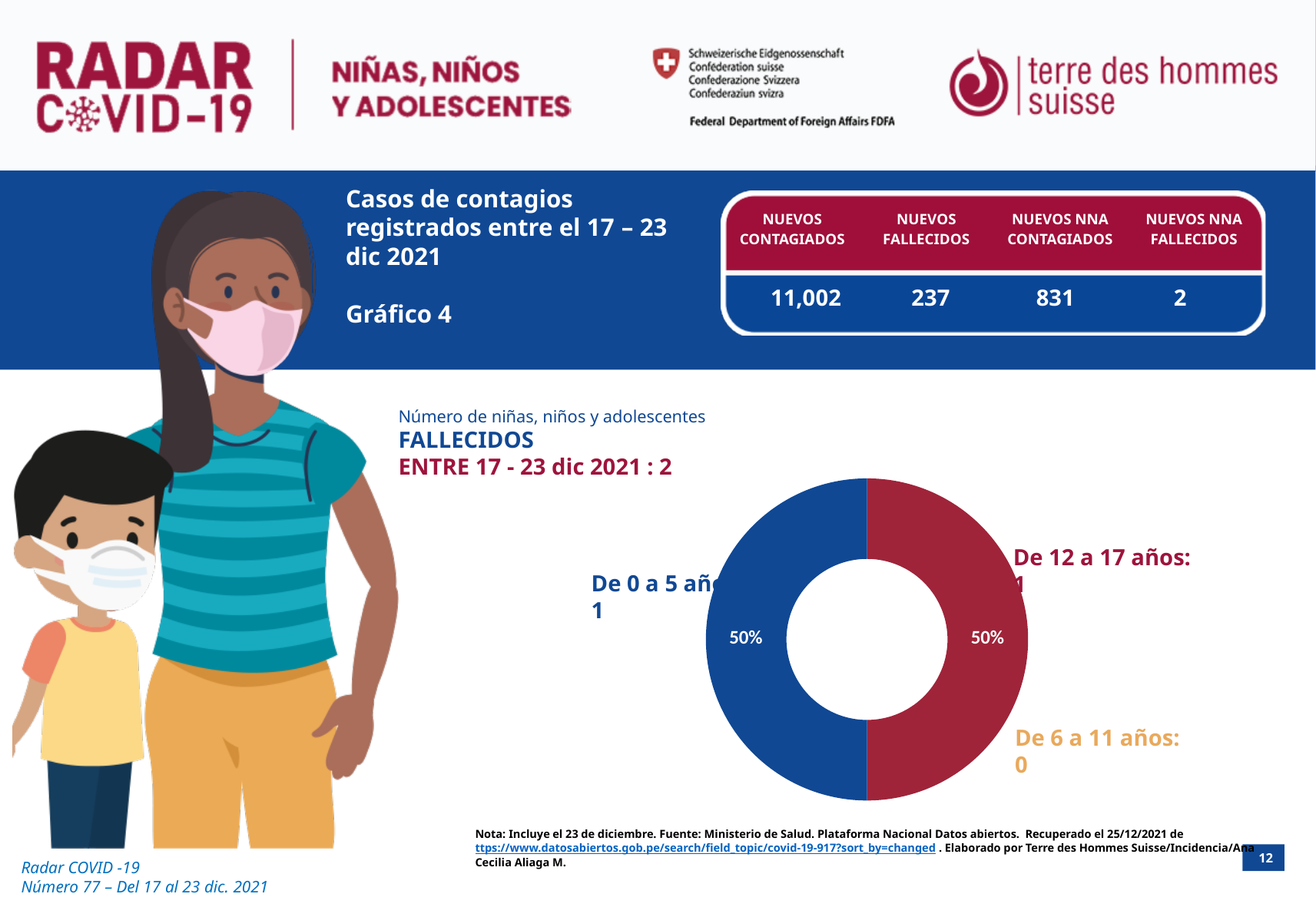
What colour is the 'De 12 a 17 años' slice of the chart? Red What share of the pie does the 'De 12 a 17 años' slice represent? 50% What is the difference between the deaths for 'De 12 a 17 años' and 'De 6 a 11 años'? 1 How many deaths are shown for the 'De 0 a 5 años' group? 1 What is the total number of deaths across all age groups shown in the chart? 2 Which of the two values is larger: 'De 0 a 5 años' or 'De 6 a 11 años'? De 0 a 5 años How many deaths are shown for the 'De 6 a 11 años' group? 0 What share of the pie does the 'De 0 a 5 años' slice represent? 50% How many age groups are labelled on the chart? 3 How many deaths are shown for the 'De 12 a 17 años' group? 1 What kind of chart is shown on the slide? Pie (donut) chart Which age group has the lowest number of deaths in the chart? De 6 a 11 años